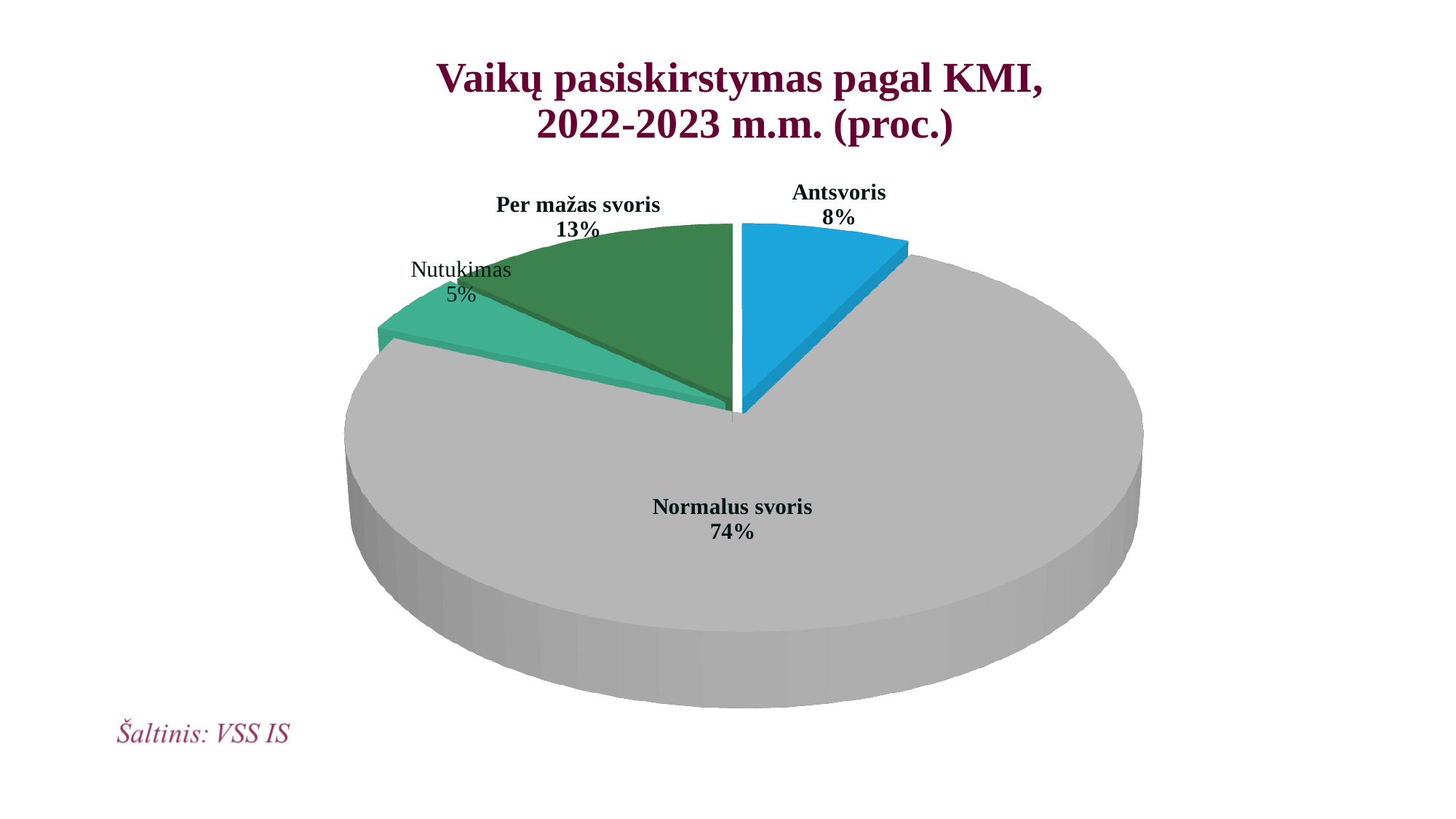
How many categories are shown in the pie chart? 4 Which is larger, the share for Antsvoris or the share for Nutukimas? Antsvoris What is the value for Antsvoris? 8% What colour is the Antsvoris slice? Blue What type of chart is shown on the slide? Pie chart What is the title of the chart? Vaikų pasiskirstymas pagal KMI, 2022-2023 m.m. (proc.) What is the value for Per mažas svoris? 13% What is the value for Nutukimas? 5% Which category has the smallest share of the pie? Nutukimas What is the difference between the shares of Per mažas svoris and Antsvoris? 5% What percentage of children have normal weight (Normalus svoris)? 74% Which category has the largest share of the pie? Normalus svoris